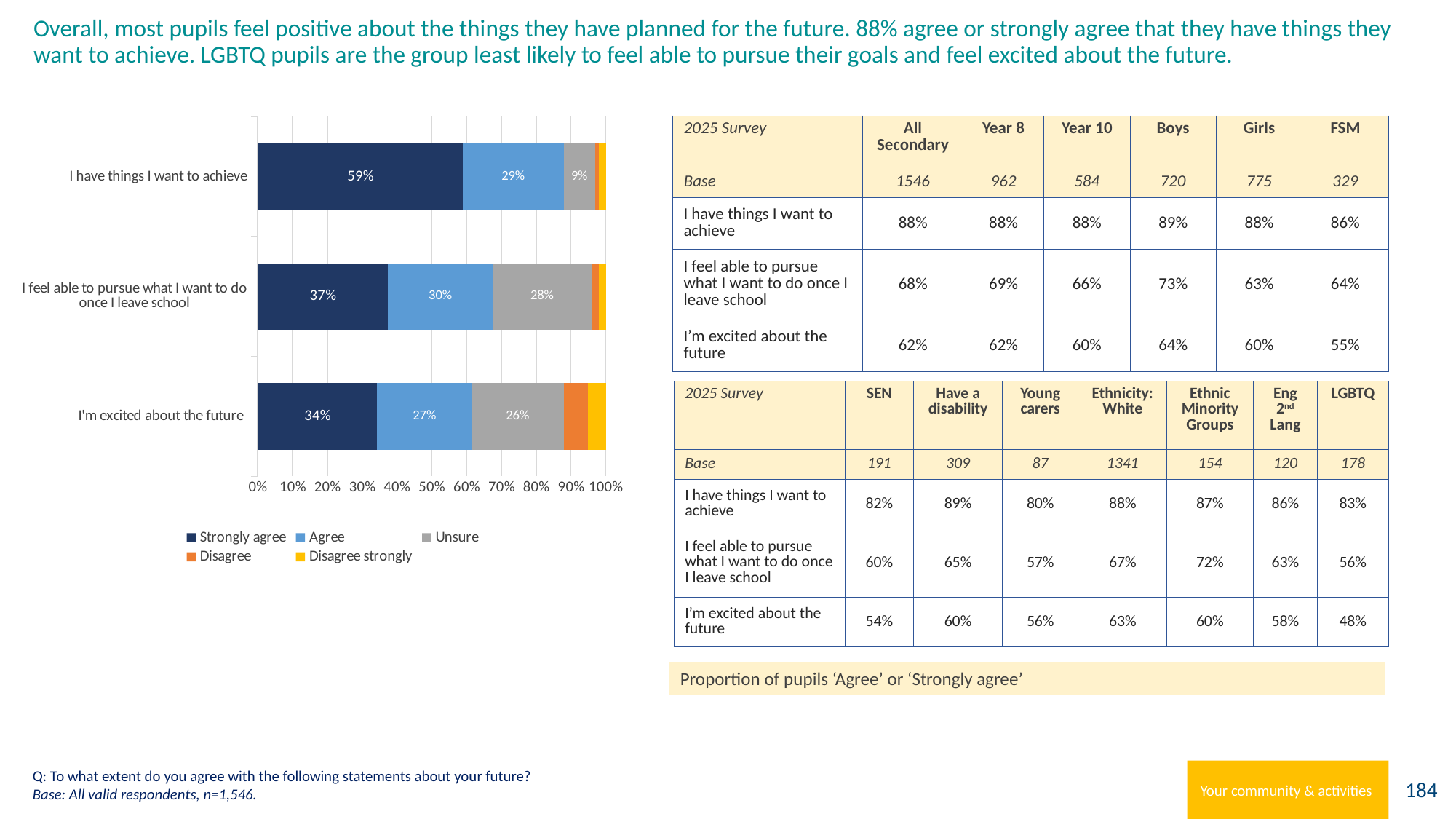
How many response categories does the bar chart's legend list? 5 In the bar chart, which statement has a larger 'Unsure' share: 'I feel able to pursue what I want to do once I leave school' or 'I'm excited about the future'? I feel able to pursue what I want to do once I leave school In the bar chart, which statement has the lowest 'Strongly agree' percentage? I'm excited about the future In the bar chart, what percentage of pupils strongly agree with 'I have things I want to achieve'? 59% How many statements are shown in the bar chart? 3 In the bar chart, which statement has the highest 'Strongly agree' percentage? I have things I want to achieve In the bar chart, what percentage of pupils are 'Unsure' about 'I'm excited about the future'? 26% In the bar chart, what percentage of pupils chose 'Agree' for 'I feel able to pursue what I want to do once I leave school'? 30% In the bar chart, what is the difference in 'Strongly agree' percentage between 'I have things I want to achieve' and 'I'm excited about the future'? 25 percentage points In the bar chart, is the 'Strongly agree' value for 'I'm excited about the future' greater or less than 40%? less In the bar chart's legend, which colour represents 'Strongly agree'? Dark blue What type of chart is shown on the left of the slide? Stacked bar chart